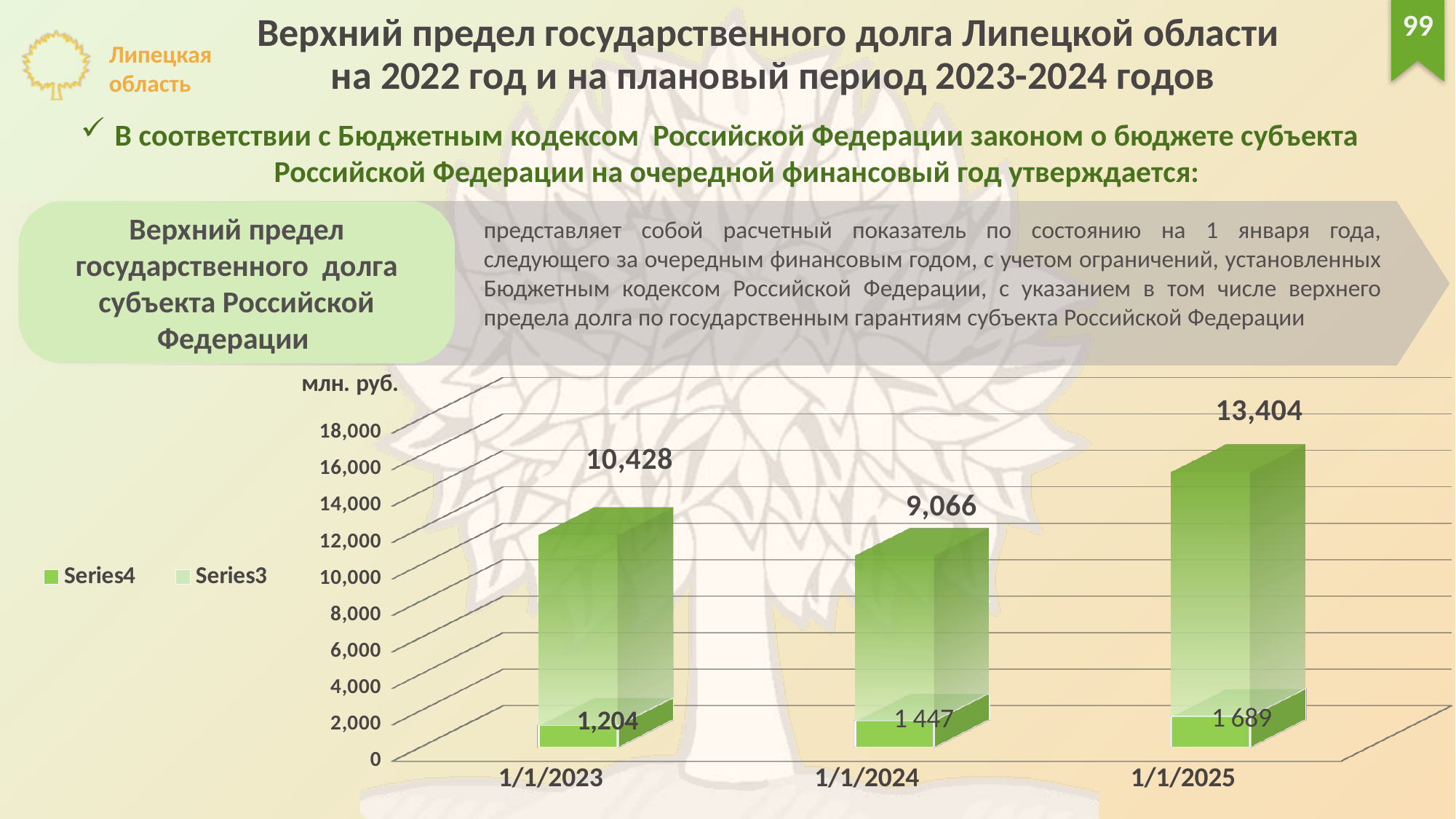
What is the Series4 value for 1/1/2025? 13,404 What is the difference between the Series4 values for 1/1/2025 and 1/1/2023? 2,976 What kind of chart is shown on the slide? bar chart What unit is shown above the vertical axis of the chart? млн. руб. What is the Series4 value for 1/1/2023? 10,428 What is the Series3 value for 1/1/2025? 1 689 Which is larger, the Series4 value for 1/1/2023 or for 1/1/2024? 1/1/2023 Which date has the highest Series4 value? 1/1/2025 Which date has the lowest Series4 value? 1/1/2024 How many dates are shown on the x axis of the chart? 3 How many series does the chart legend list? 2 What is the Series3 value for 1/1/2024? 1 447